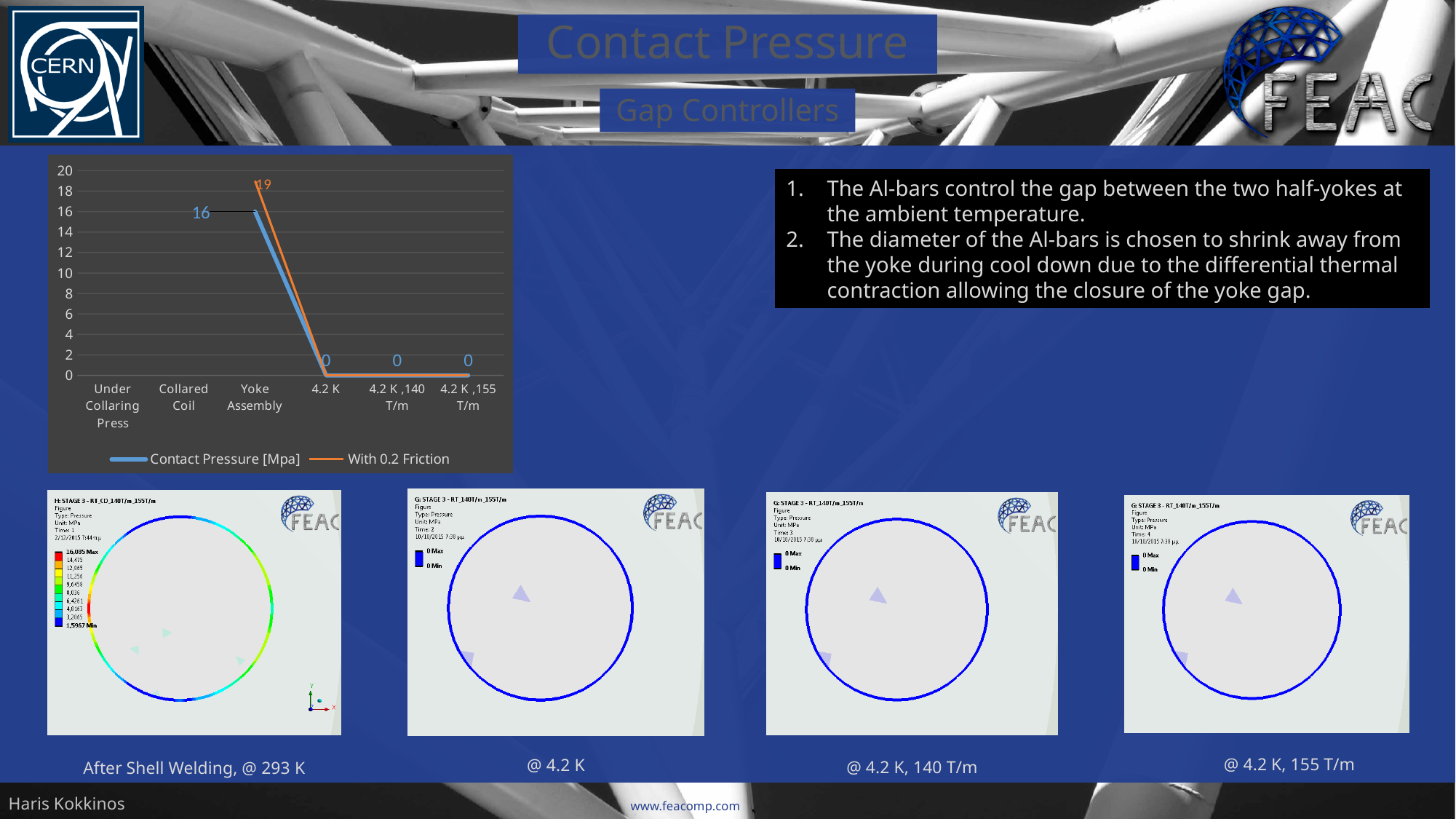
How many series does the chart legend list? 2 What is the value shown at 4.2 K ,155 T/m? 0 What is the With 0.2 Friction value at Yoke Assembly? 19 What is the Contact Pressure [Mpa] value at Yoke Assembly? 16 How many categories are shown on the x axis of the chart? 6 At Yoke Assembly, which series has the larger value, Contact Pressure [Mpa] or With 0.2 Friction? With 0.2 Friction What is the Contact Pressure [Mpa] value at 4.2 K? 0 At which category does the Contact Pressure [Mpa] series reach its highest value? Yoke Assembly What are the two series names listed in the chart legend? Contact Pressure [Mpa] and With 0.2 Friction What is the difference between the With 0.2 Friction value and the Contact Pressure [Mpa] value at Yoke Assembly? 3 Do the plotted values rise or fall from Yoke Assembly to 4.2 K? Fall What kind of chart is shown on the slide? Line chart